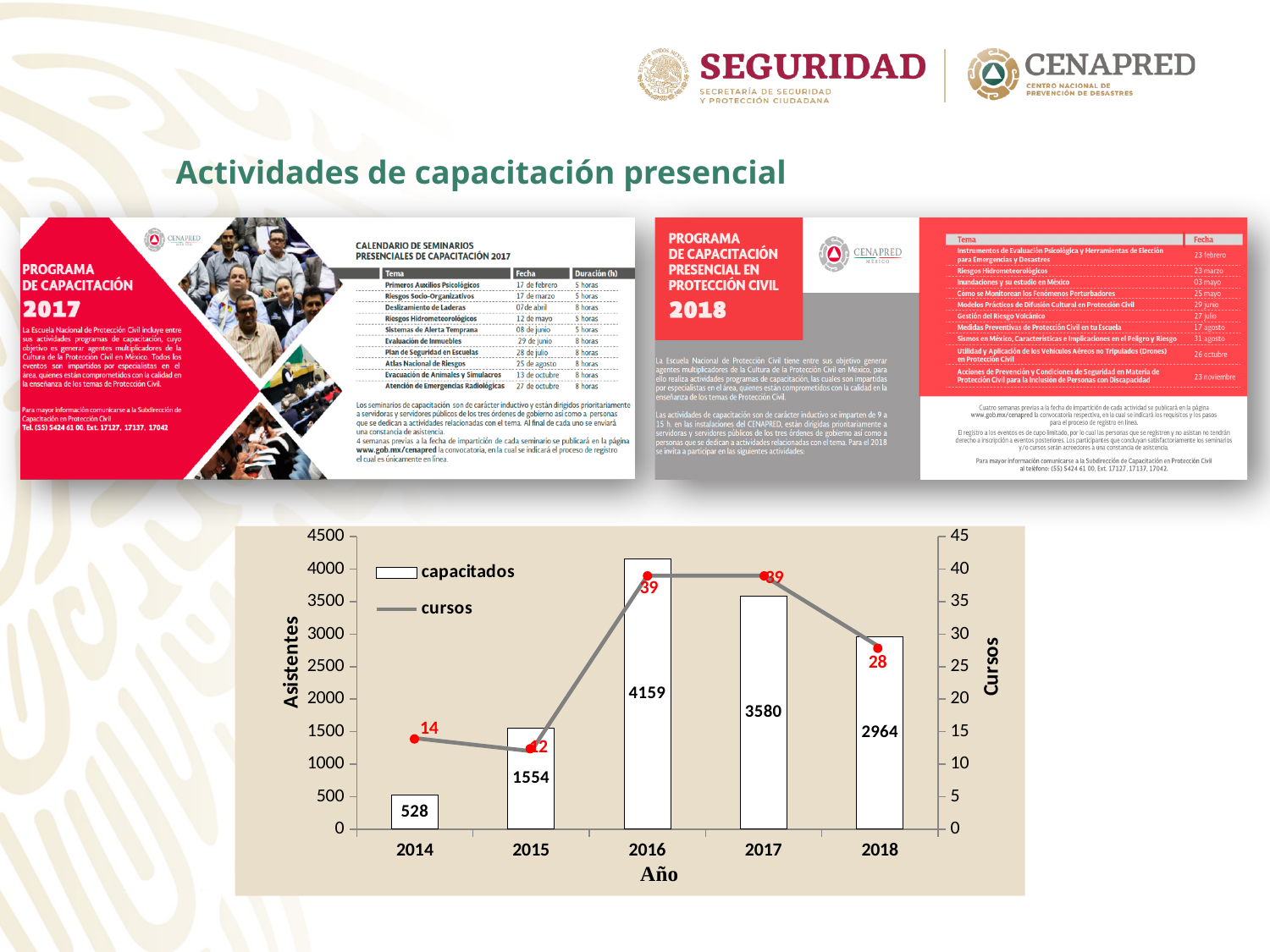
What is the label of the left vertical axis? Asistentes What is the value of cursos for 2018? 28 How many capacitados were there in 2014? 528 Which year has the lowest value for cursos? 2015 What is the difference in capacitados between 2017 and 2018? 616 How many series does the legend list? 2 How many years are shown on the x axis? 5 How many capacitados were there in 2016? 4159 Is the value of capacitados for 2017 greater or less than 3500? greater Which year had more capacitados, 2015 or 2018? 2018 Did the number of capacitados rise or fall from 2016 to 2018? fall Which year has the highest number of capacitados? 2016